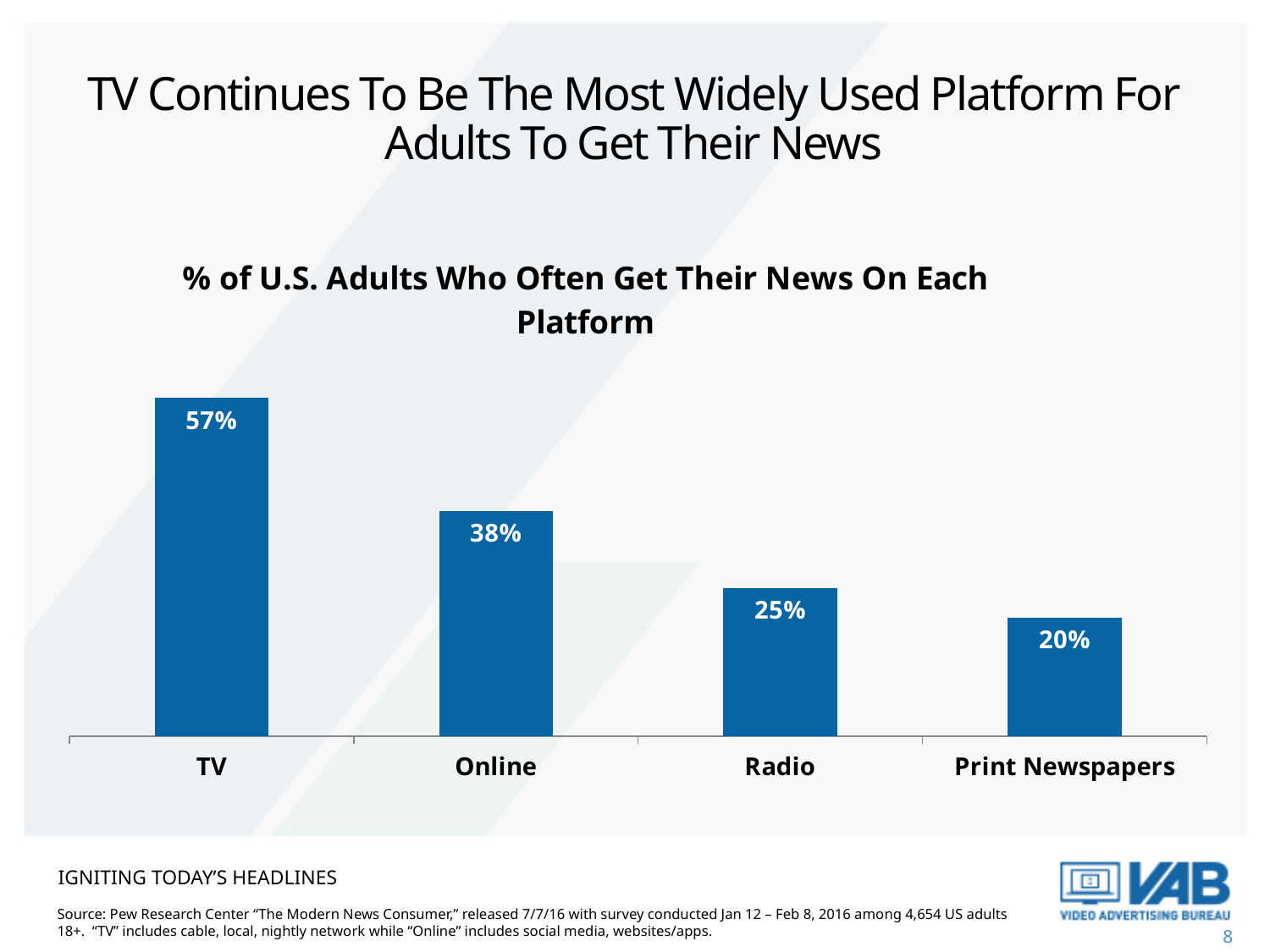
What is the value shown for Online? 38% Which platform has the highest percentage? TV Which is larger, the value for Online or the value for Radio? Online What is the value shown for Print Newspapers? 20% What is the difference in percentage points between Radio and Print Newspapers? 5 What is the difference in percentage points between TV and Online? 19 What kind of chart is shown on the slide? Bar chart Which platform has the lowest percentage? Print Newspapers How many platforms are shown in the chart? 4 What percentage of U.S. adults often get their news on TV? 57% Do the values rise or fall moving from left to right across the platforms? Fall What is the value shown for Radio? 25%